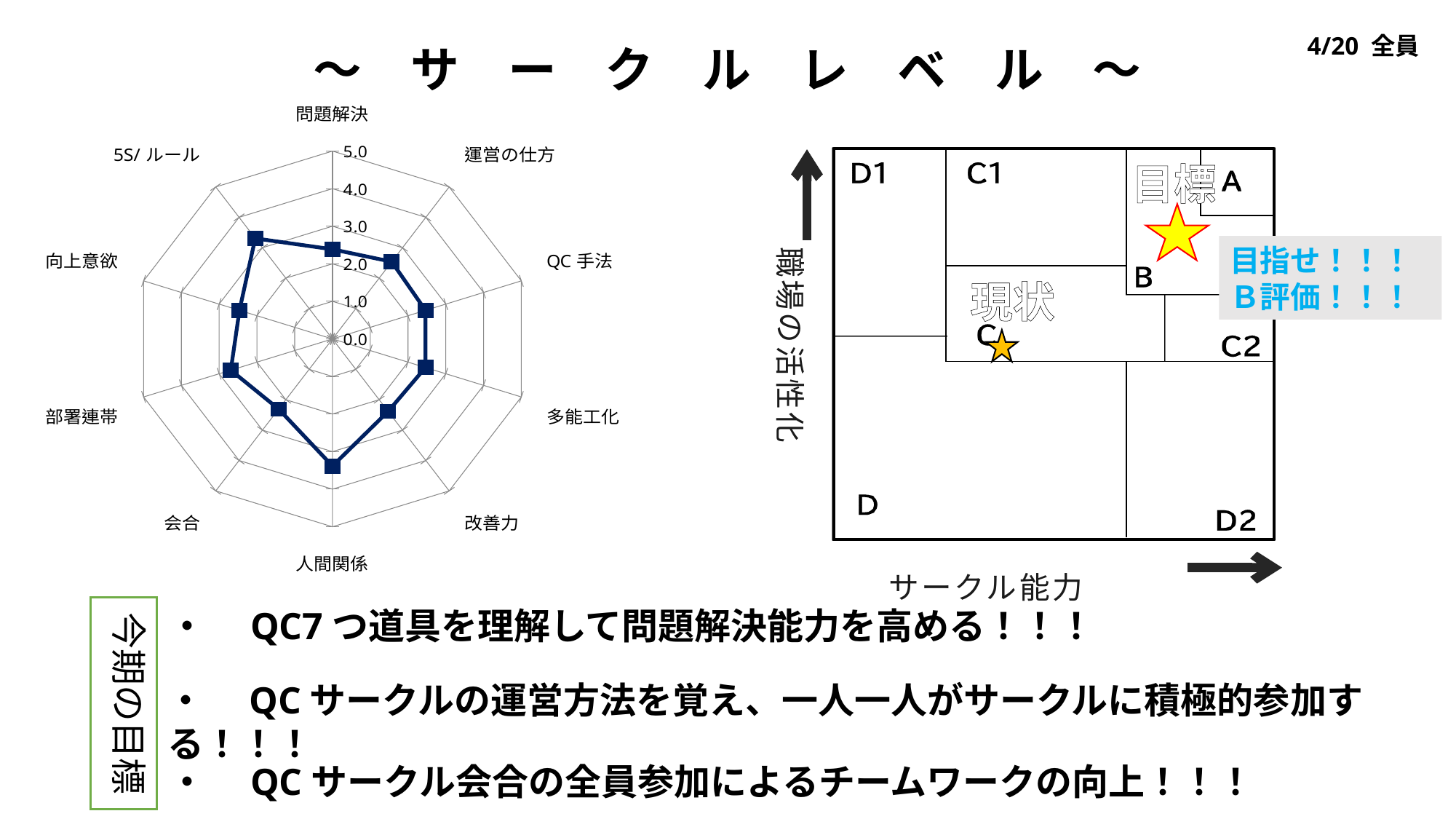
On the radar chart, which has the larger value, 人間関係 or 会合? 人間関係 What is the maximum value shown on the radar chart's axis scale? 5.0 On the radar chart, is the value for 会合 greater or less than 2.0? greater How many categories (axes) does the radar chart have? 10 On the radar chart, is the value for 改善力 greater or less than 3.0? less What is the title written at the top of the slide above the charts? ～ サークルレベル ～ On the radar chart, is the value for 5S/ ルール greater or less than 3.0? greater What kind of chart is shown on the left of the slide? radar chart On the radar chart, which has the larger value, 5S/ ルール or 問題解決? 5S/ ルール On the radar chart, which has the larger value, 人間関係 or 改善力? 人間関係